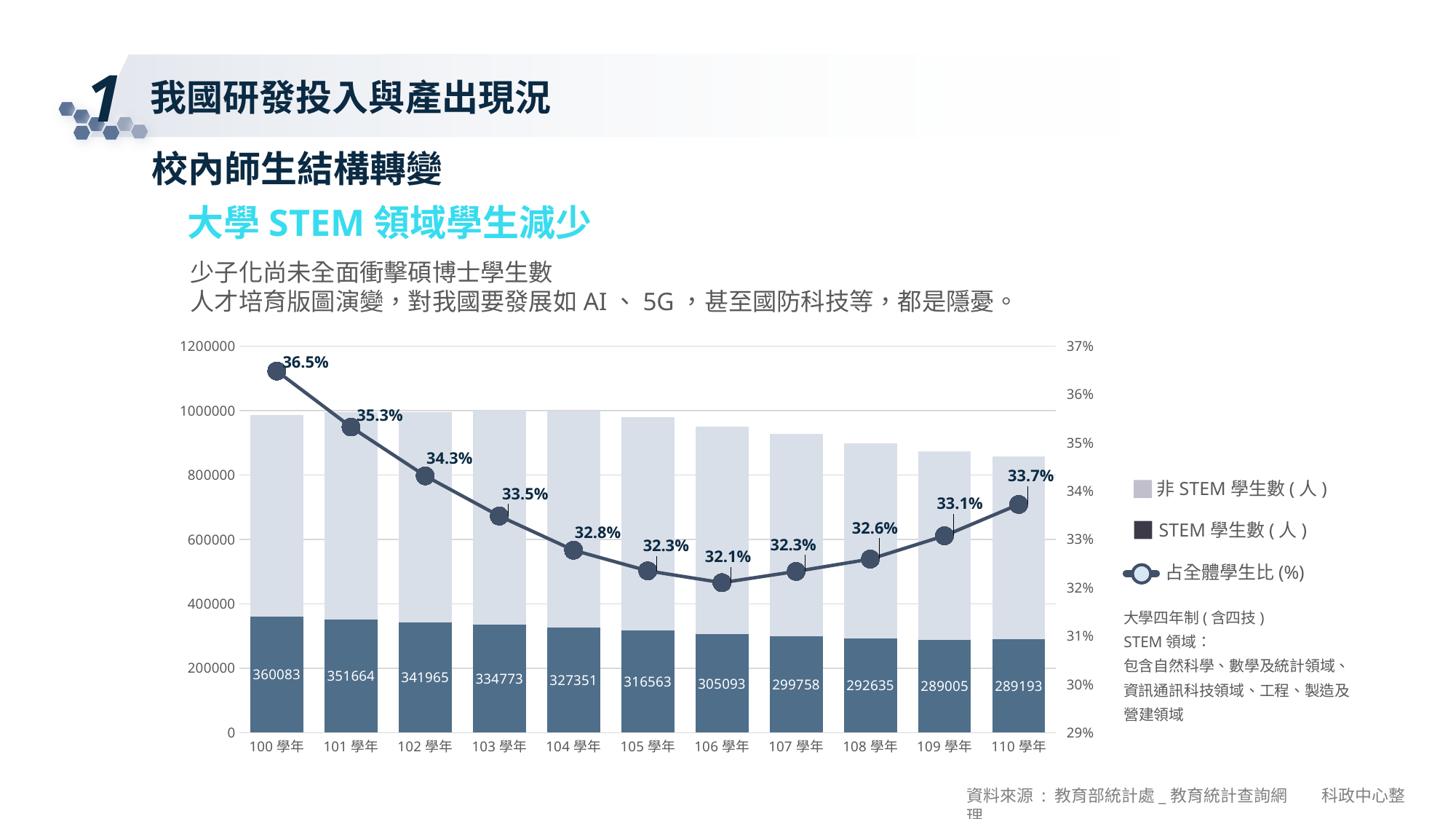
Which academic year has the lowest 占全體學生比 (%)? 106 學年 What is the 占全體學生比 (%) value for 106 學年? 32.1% Which is larger, the 占全體學生比 (%) for 101 學年 or for 109 學年? 101 學年 How many academic years are shown on the x axis? 11 What kind of chart is shown on the slide? Stacked bar chart with a line How many series does the legend list? 3 Which academic year has the highest STEM 學生數? 100 學年 Which academic year has the lowest STEM 學生數 according to the data labels? 109 學年 What is the difference in STEM 學生數 between 100 學年 and 110 學年? 70890 Is the total stacked bar height for 110 學年 greater or less than 800000? greater Does the 占全體學生比 (%) line rise or fall from 100 學年 to 106 學年? fall What is the STEM 學生數 value for 100 學年? 360083